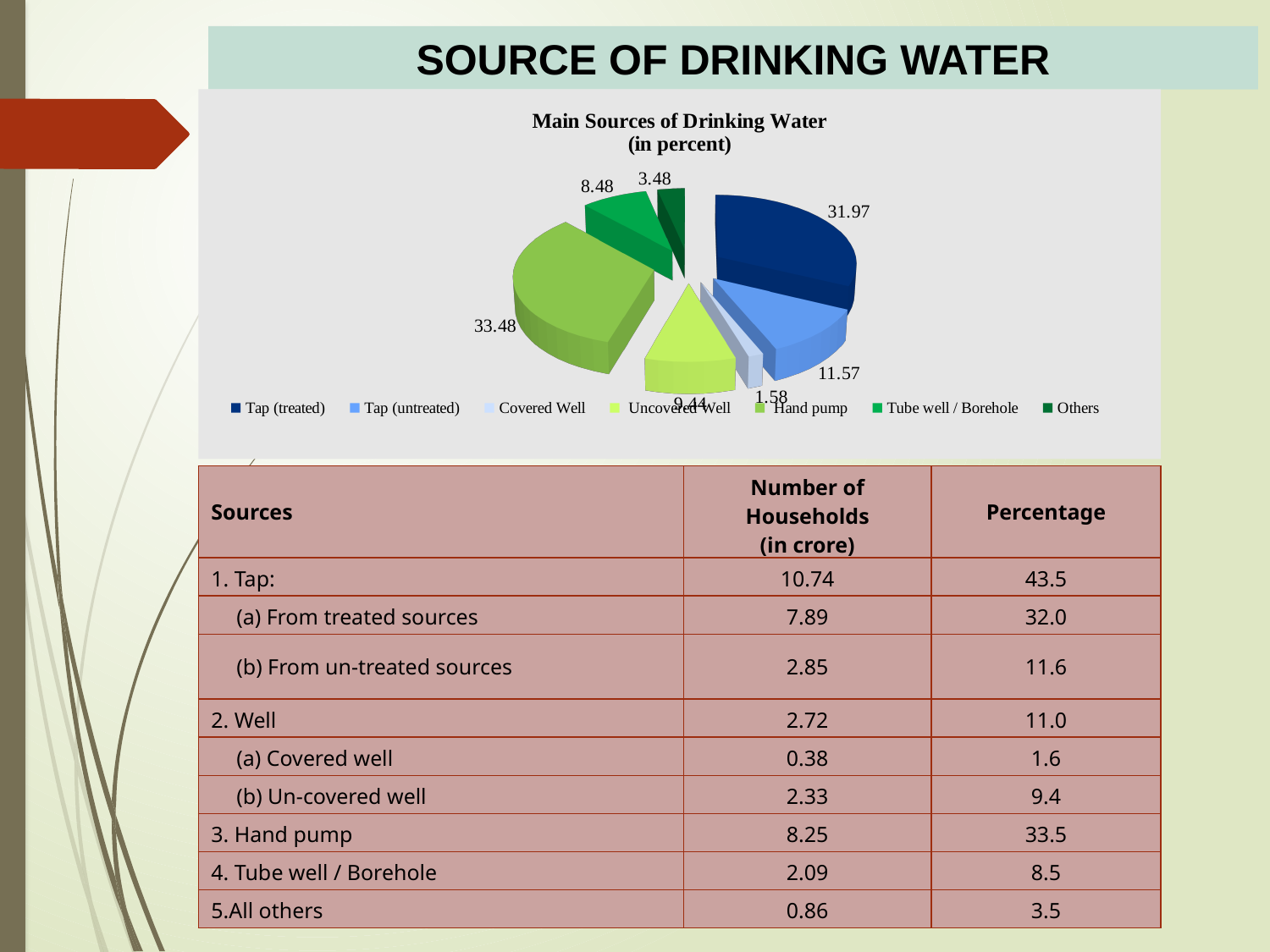
What kind of chart is shown on the slide? Pie chart What is the difference between the values for Hand pump and Tap (treated) in the pie chart? 1.51 What is the value for Hand pump in the pie chart? 33.48 How many categories does the pie chart legend list? 7 Which is larger in the pie chart, Tap (untreated) or Tube well / Borehole? Tap (untreated) Which category has the smallest slice in the pie chart? Covered Well What is the value for Tap (treated) in the pie chart? 31.97 What is the title of the pie chart? Main Sources of Drinking Water (in percent) What is the value for Others in the pie chart? 3.48 What is the value for Tap (untreated) in the pie chart? 11.57 What is the value for Tube well / Borehole in the pie chart? 8.48 Which category has the largest slice in the pie chart? Hand pump